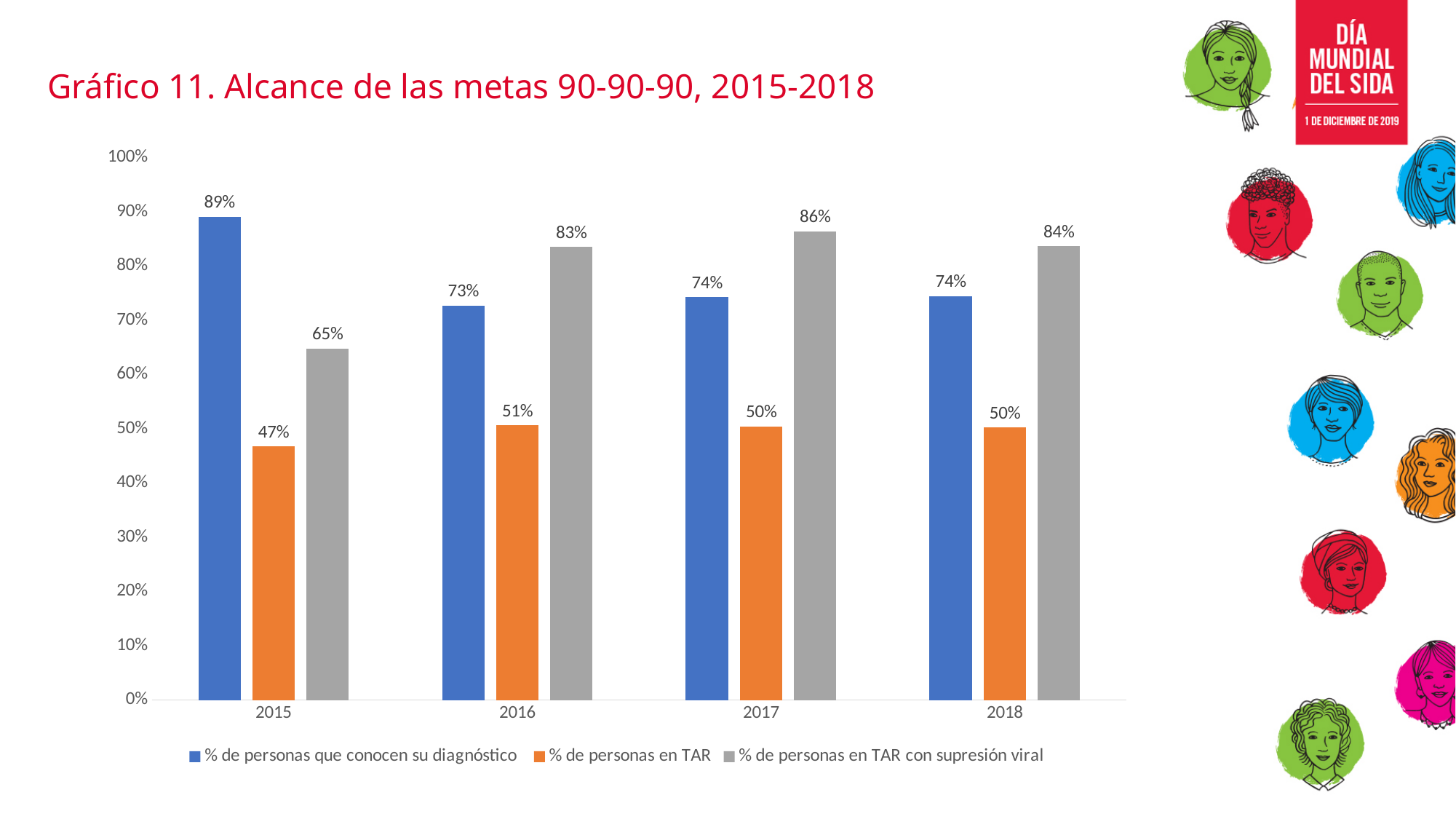
Which is larger in 2016: '% de personas que conocen su diagnóstico' or '% de personas en TAR con supresión viral'? % de personas en TAR con supresión viral How many years are shown on the x axis? 4 What is the value for '% de personas en TAR' in 2016? 51% What is the value for '% de personas en TAR con supresión viral' in 2017? 86% In which year is '% de personas en TAR con supresión viral' lowest? 2015 In which year is '% de personas que conocen su diagnóstico' highest? 2015 What is the value for '% de personas en TAR' in 2018? 50% How many series does the legend list? 3 What is the title of the chart? Gráfico 11. Alcance de las metas 90-90-90, 2015-2018 What kind of chart is shown on the slide? Bar chart What is the value for '% de personas que conocen su diagnóstico' in 2015? 89% What is the difference between '% de personas que conocen su diagnóstico' and '% de personas en TAR' in 2015? 42%